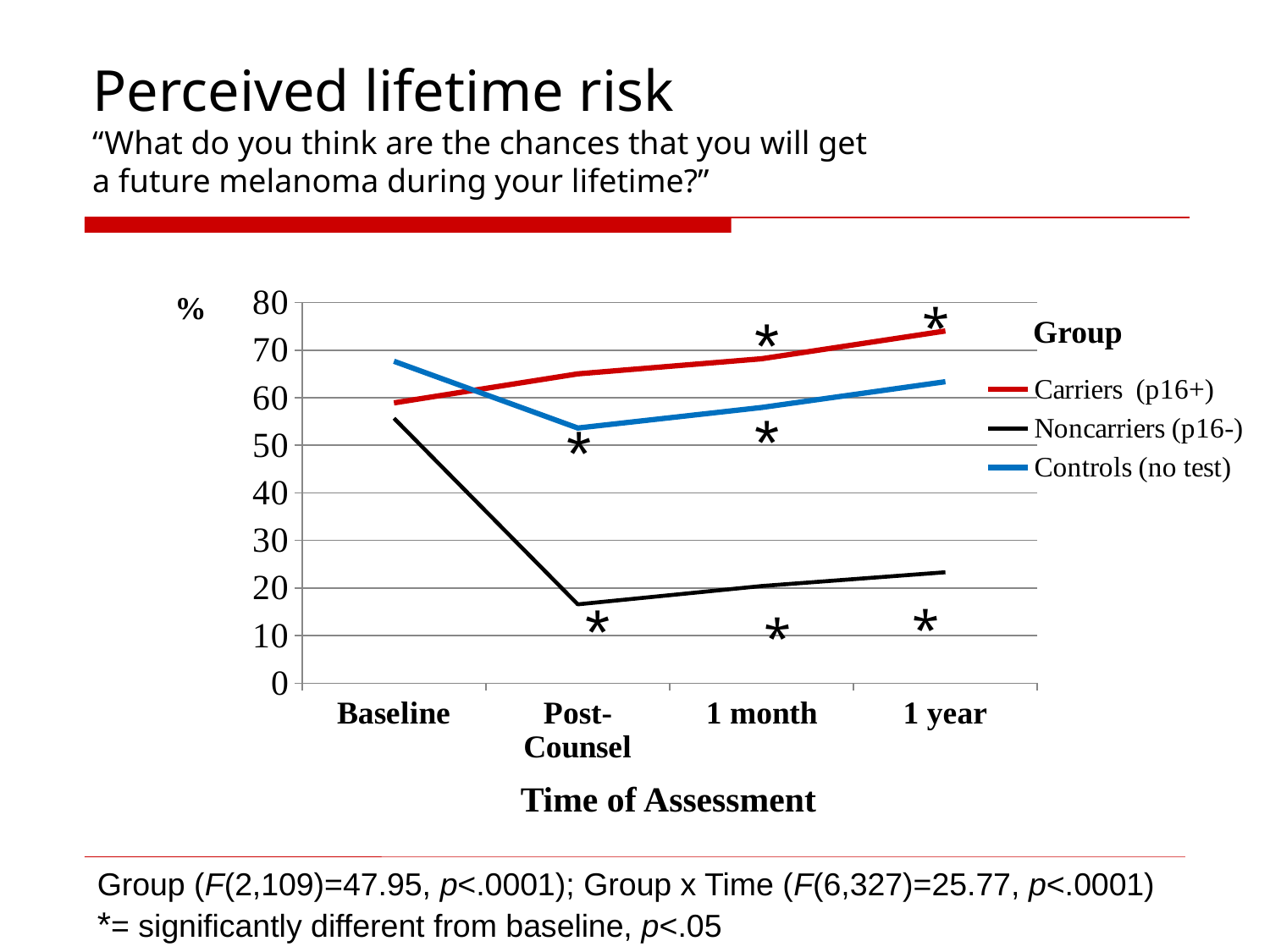
How many time points are shown on the x axis? 4 What is the label of the x axis? Time of Assessment Do the values for Noncarriers (p16-) rise or fall from Baseline to Post-Counsel? fall Which group has the highest perceived lifetime risk at Baseline? Controls (no test) Is the value for Carriers (p16+) at 1 year greater or less than 70? greater What kind of chart is shown on the slide? line chart Which group has the highest perceived lifetime risk at 1 month? Carriers (p16+) Do the values for Carriers (p16+) rise or fall from Baseline to 1 year? rise Which group has the lowest perceived lifetime risk at 1 year? Noncarriers (p16-) Is the value for Noncarriers (p16-) at Post-Counsel greater or less than 20? less At Post-Counsel, which is larger: the value for Carriers (p16+) or Controls (no test)? Carriers (p16+) How many series does the legend list? 3